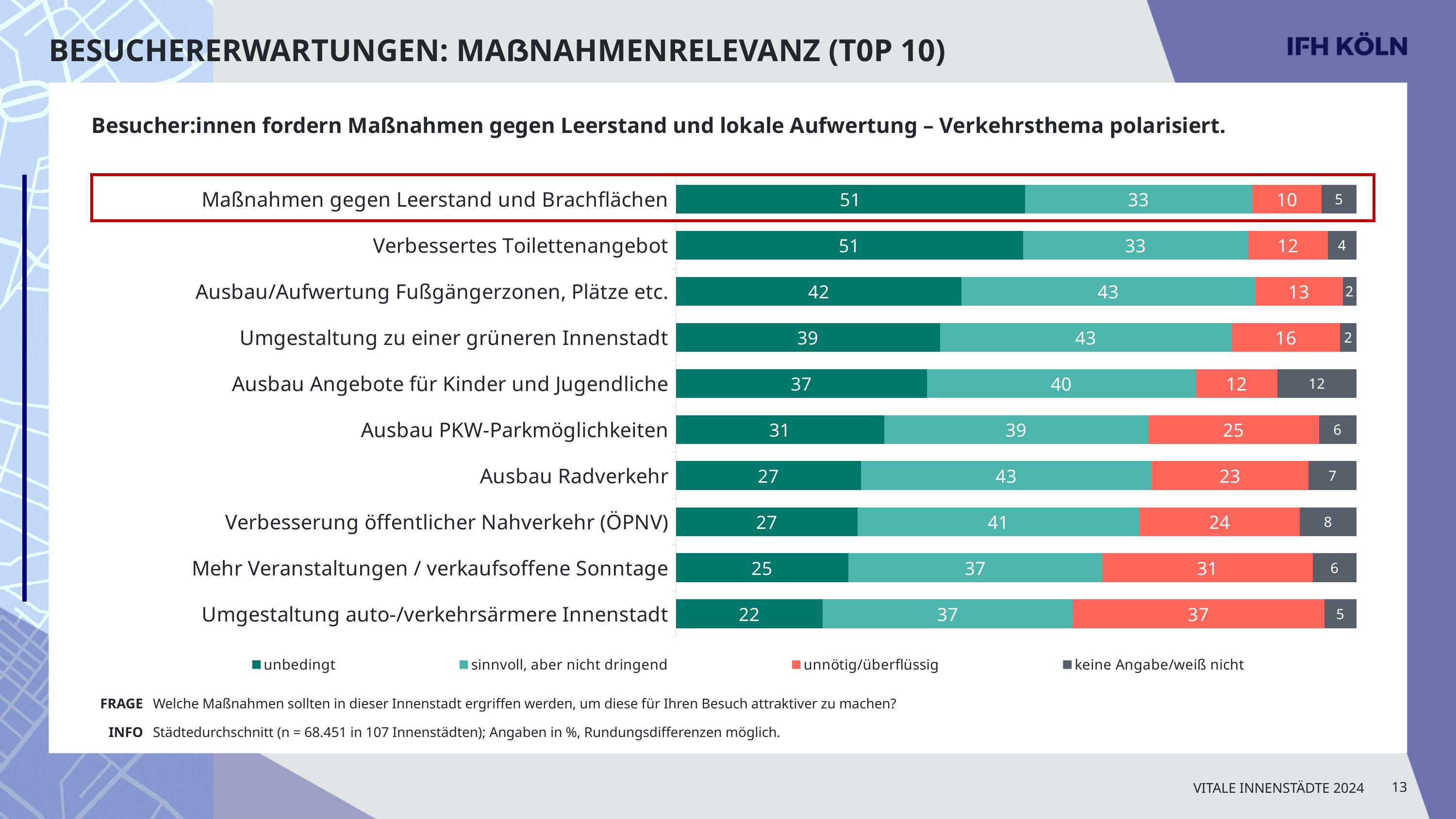
Which measure has the highest 'keine Angabe/weiß nicht' value? Ausbau Angebote für Kinder und Jugendliche What is the 'unbedingt' value for 'Verbessertes Toilettenangebot'? 51 Which measure has the highest 'unnötig/überflüssig' value? Umgestaltung auto-/verkehrsärmere Innenstadt What kind of chart is shown on the slide? Stacked bar chart Which is larger: the 'unnötig/überflüssig' value for 'Mehr Veranstaltungen / verkaufsoffene Sonntage' or for 'Verbesserung öffentlicher Nahverkehr (ÖPNV)'? Mehr Veranstaltungen / verkaufsoffene Sonntage What is the 'unnötig/überflüssig' value for 'Ausbau PKW-Parkmöglichkeiten'? 25 Which legend entry is shown in red? unnötig/überflüssig What is the difference between the 'unbedingt' values for 'Maßnahmen gegen Leerstand und Brachflächen' and 'Ausbau Radverkehr'? 24 How many measures (categories) are listed in the chart? 10 How many series does the legend list? 4 What is the 'keine Angabe/weiß nicht' value for 'Ausbau Angebote für Kinder und Jugendliche'? 12 Which measure has the lowest 'unbedingt' value? Umgestaltung auto-/verkehrsärmere Innenstadt